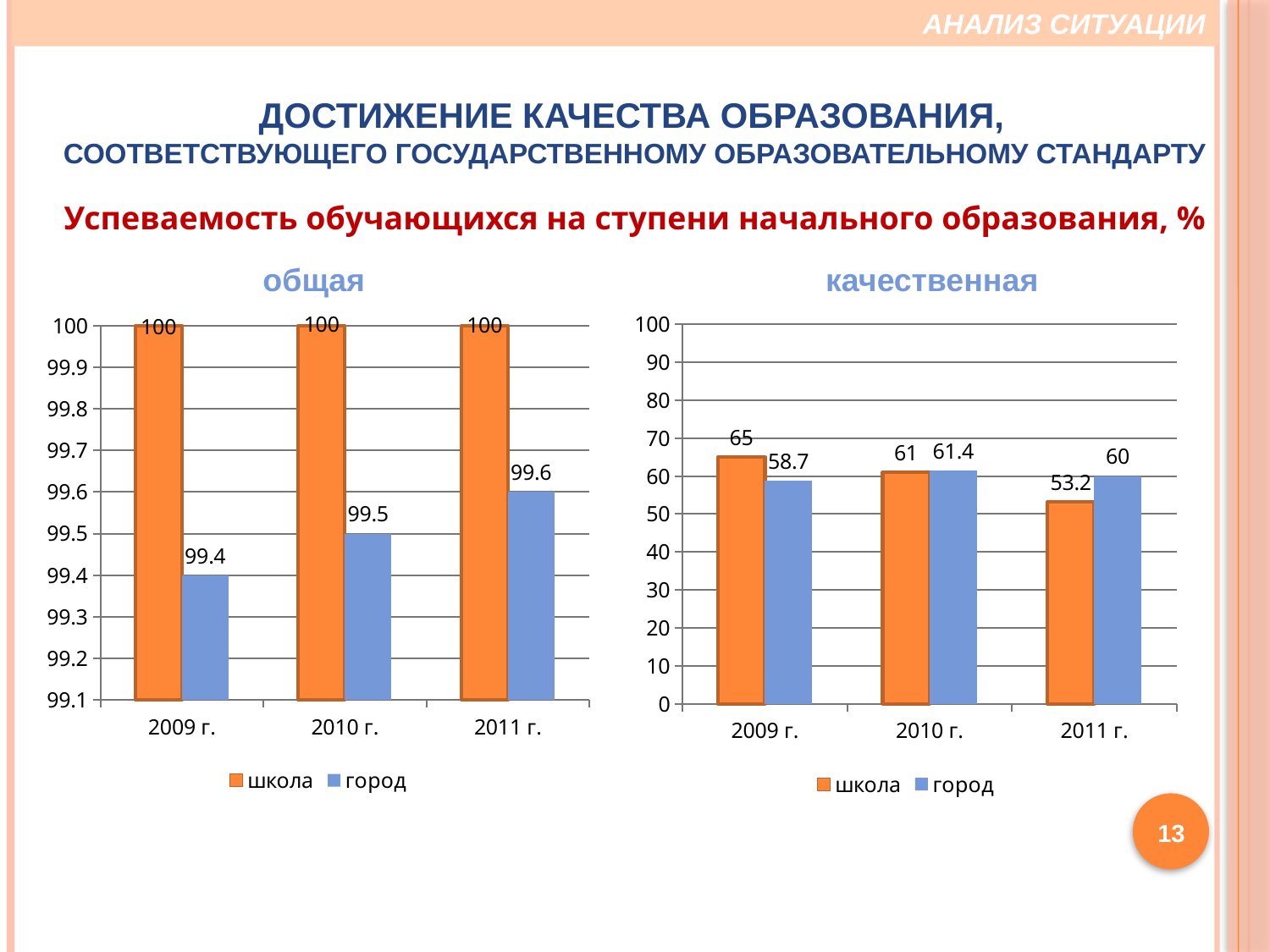
What kind of chart is the 'качественная' chart? bar chart In the 'качественная' chart, what is the value for 'школа' in 2011 г.? 53.2 In the 'общая' chart, what is the value for 'город' in 2009 г.? 99.4 In the 'общая' chart, does the value for 'город' rise or fall from 2009 г. to 2011 г.? rise In the 'качественная' chart, does the value for 'школа' rise or fall from 2009 г. to 2011 г.? fall How many series does the legend of the 'общая' chart list? 2 In the 'качественная' chart, which is larger in 2011 г., 'школа' or 'город'? город In the 'общая' chart, what is the value for 'школа' in 2011 г.? 100 In the 'общая' chart, which year has the lowest value for 'город'? 2009 г. In the 'качественная' chart, which year has the highest value for 'школа'? 2009 г. In the 'качественная' chart, what is the difference between 'школа' and 'город' in 2009 г.? 6.3 In the 'качественная' chart, what is the value for 'город' in 2010 г.? 61.4